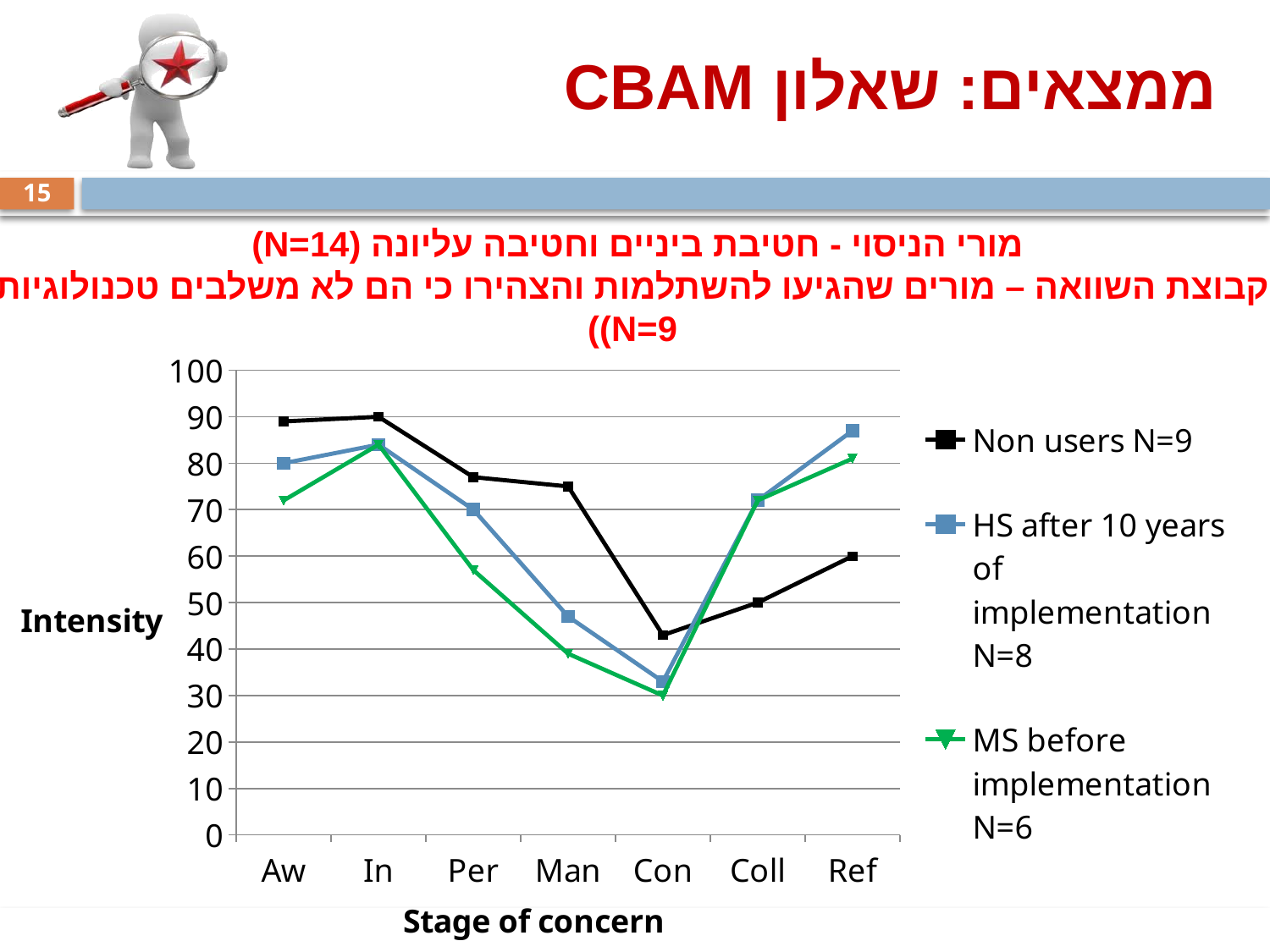
At which stage of concern does the Non users N=9 series reach its lowest value? Con Do the values for Non users N=9 rise or fall from In to Con? fall What is the title of the x axis? Stage of concern What kind of chart is shown on the slide? line chart How many stages of concern are shown on the x axis? 7 At Man, which series has the larger value: Non users N=9 or HS after 10 years of implementation N=8? Non users N=9 Is the value for MS before implementation N=6 at Con greater or less than 40? less Is the value for Non users N=9 at Con greater or less than 50? less At Ref, which series has the larger value: HS after 10 years of implementation N=8 or Non users N=9? HS after 10 years of implementation N=8 Is the value for Non users N=9 at Aw greater or less than 80? greater How many series does the legend list? 3